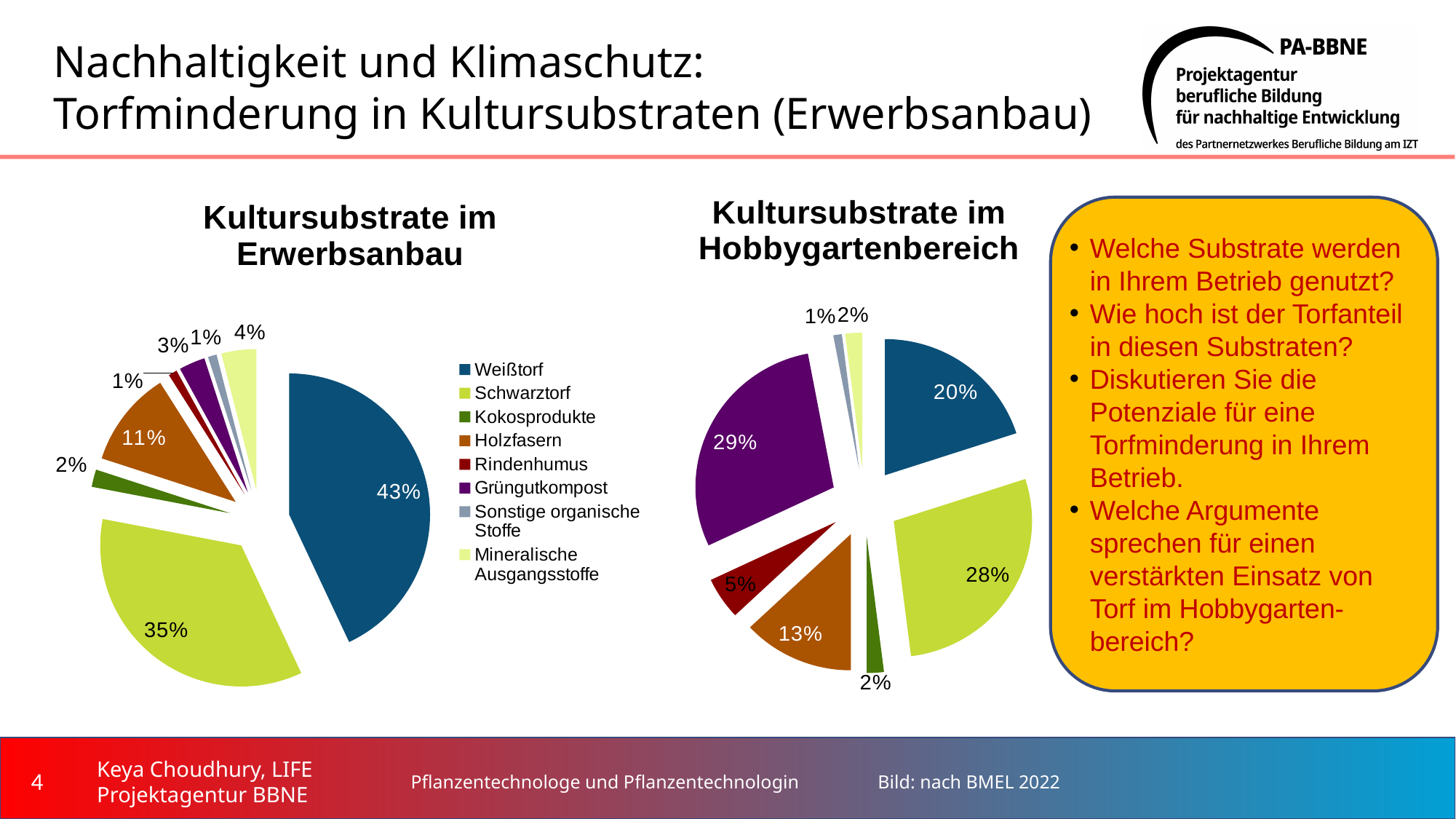
What type of chart is 'Kultursubstrate im Hobbygartenbereich'? Pie chart How many entries does the legend of the chart 'Kultursubstrate im Erwerbsanbau' list? 8 In the chart 'Kultursubstrate im Hobbygartenbereich', what is the largest share shown? 29% In the chart 'Kultursubstrate im Erwerbsanbau', what share does Weißtorf have? 43% In the chart 'Kultursubstrate im Hobbygartenbereich', what share does the Holzfasern (brown) slice have? 13% Which colour represents Grüngutkompost in the legend of the chart 'Kultursubstrate im Erwerbsanbau'? Purple In the chart 'Kultursubstrate im Erwerbsanbau', which is larger: Holzfasern or Mineralische Ausgangsstoffe? Holzfasern In the chart 'Kultursubstrate im Erwerbsanbau', what share does Holzfasern have? 11% In the chart 'Kultursubstrate im Hobbygartenbereich', which is larger: the Schwarztorf slice or the Weißtorf slice? Schwarztorf In the chart 'Kultursubstrate im Erwerbsanbau', what is the difference between the shares of Weißtorf and Schwarztorf? 8 percentage points In the chart 'Kultursubstrate im Erwerbsanbau', which category has the largest share? Weißtorf In the chart 'Kultursubstrate im Hobbygartenbereich', what share does the Weißtorf (dark blue) slice have? 20%